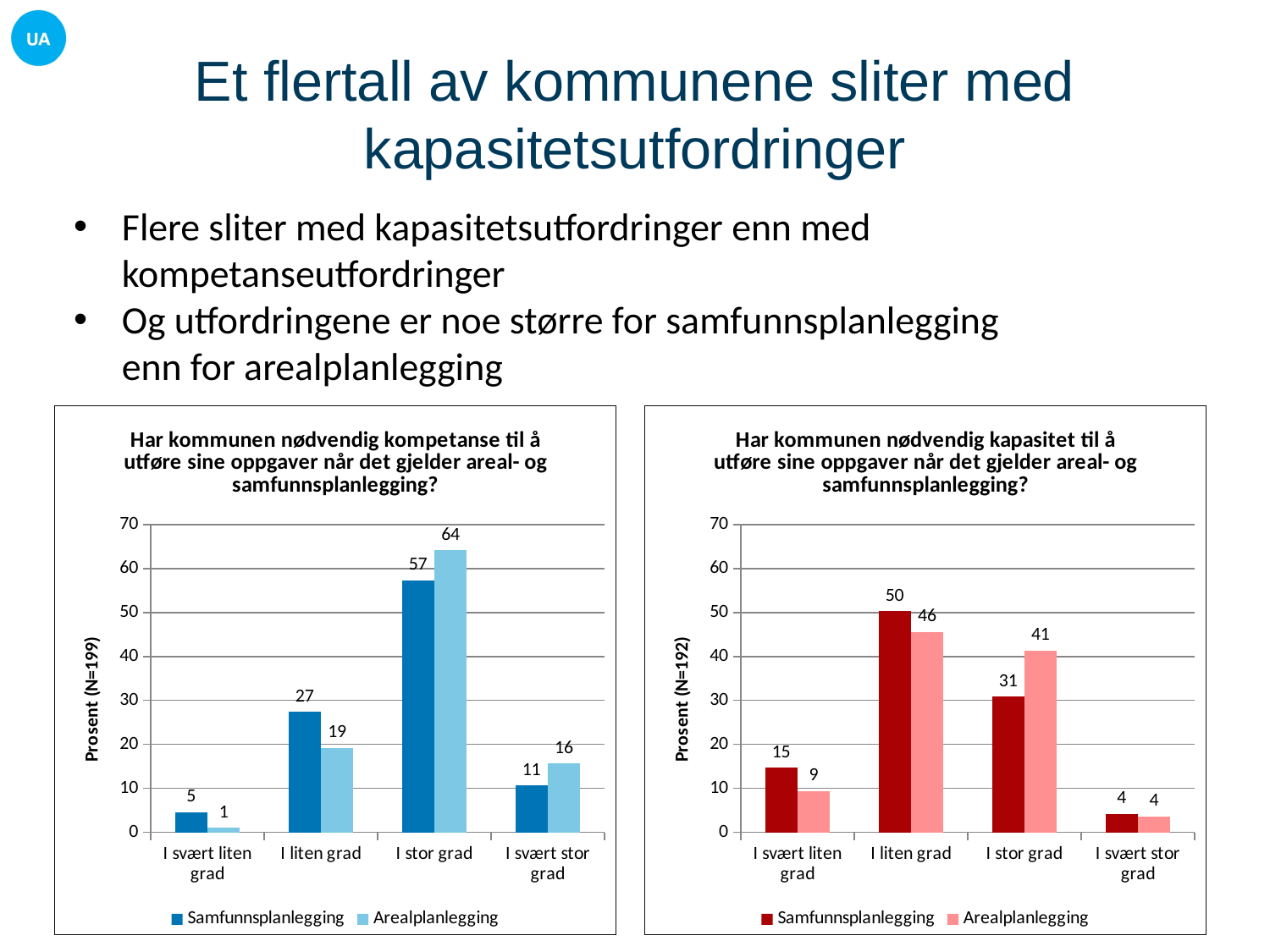
In the right chart (kapasitet), what is the difference between Samfunnsplanlegging and Arealplanlegging in the category 'I svært liten grad'? 6 How many series does the legend of the right chart (kapasitet) list? 2 How many categories are shown on the x axis of the left chart (kompetanse)? 4 In the left chart (kompetanse), what is the difference between Arealplanlegging and Samfunnsplanlegging in the category 'I stor grad'? 7 In the left chart (kompetanse), which category has the highest value for Arealplanlegging? I stor grad In the left chart (kompetanse), what is the value for Samfunnsplanlegging in the category 'I stor grad'? 57 What type of chart is the right chart (kapasitet)? Bar chart In the right chart (kapasitet), which category has the lowest value for Samfunnsplanlegging? I svært stor grad In the right chart (kapasitet), what is the value for Arealplanlegging in the category 'I stor grad'? 41 In the right chart (kapasitet), which is larger in the category 'I stor grad': Samfunnsplanlegging or Arealplanlegging? Arealplanlegging In the right chart (kapasitet), what is the value for Samfunnsplanlegging in the category 'I liten grad'? 50 In the left chart (kompetanse), what is the value for Arealplanlegging in the category 'I liten grad'? 19